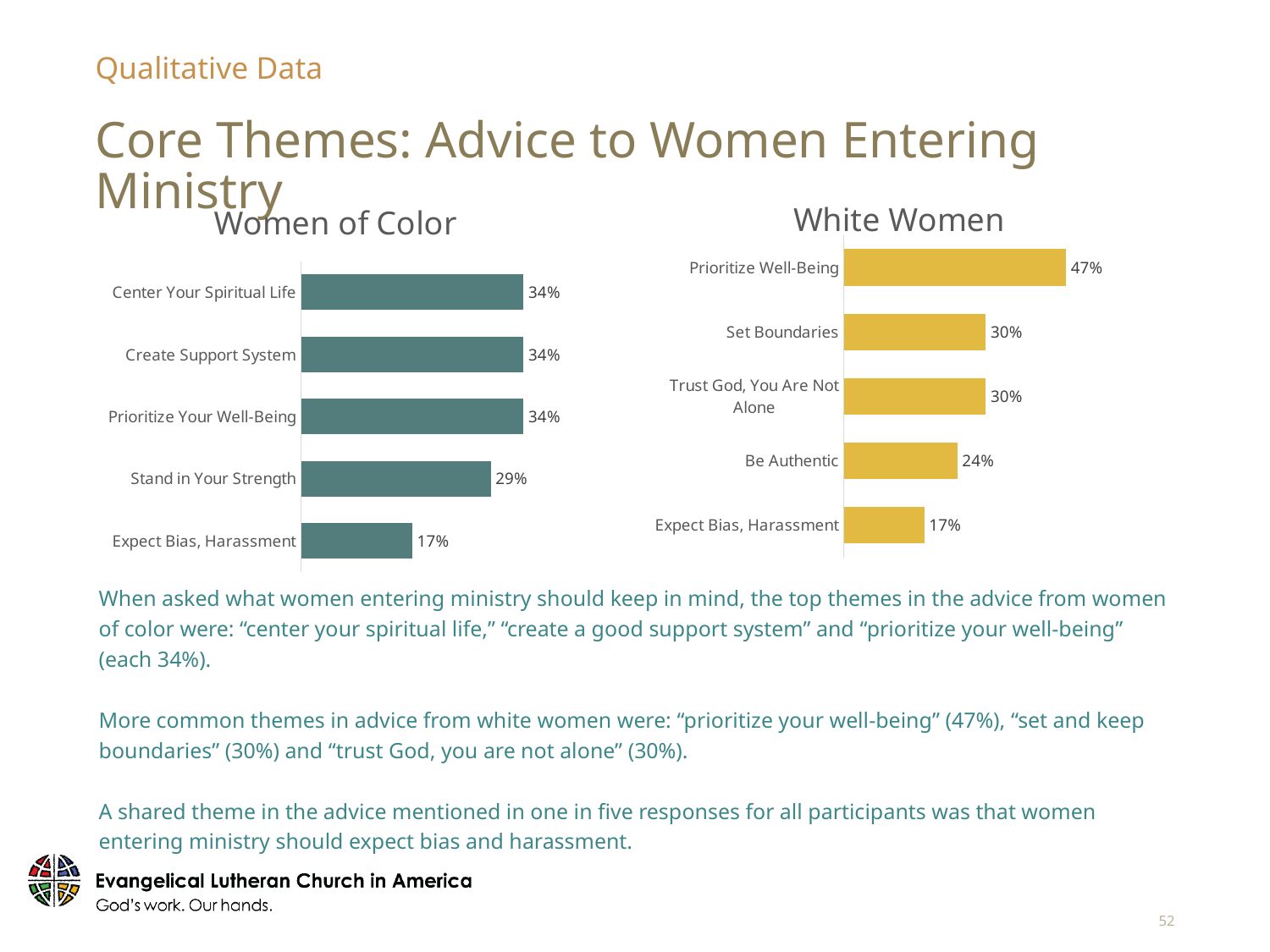
In the Women of Color chart, which category has the lowest value? Expect Bias, Harassment In the White Women chart, what is the difference between Prioritize Well-Being and Set Boundaries? 17% In the White Women chart, which category has the highest value? Prioritize Well-Being In the Women of Color chart, what is the value for Expect Bias, Harassment? 17% How many categories are shown in the Women of Color chart? 5 In the Women of Color chart, what is the value for Stand in Your Strength? 29% In the White Women chart, what is the value for Prioritize Well-Being? 47% In the Women of Color chart, what is the difference between Stand in Your Strength and Expect Bias, Harassment? 12% What kind of chart is the White Women chart? Bar chart What colour are the bars in the Women of Color chart? Teal In the White Women chart, what is the value for Be Authentic? 24% In the White Women chart, which is larger: Be Authentic or Expect Bias, Harassment? Be Authentic